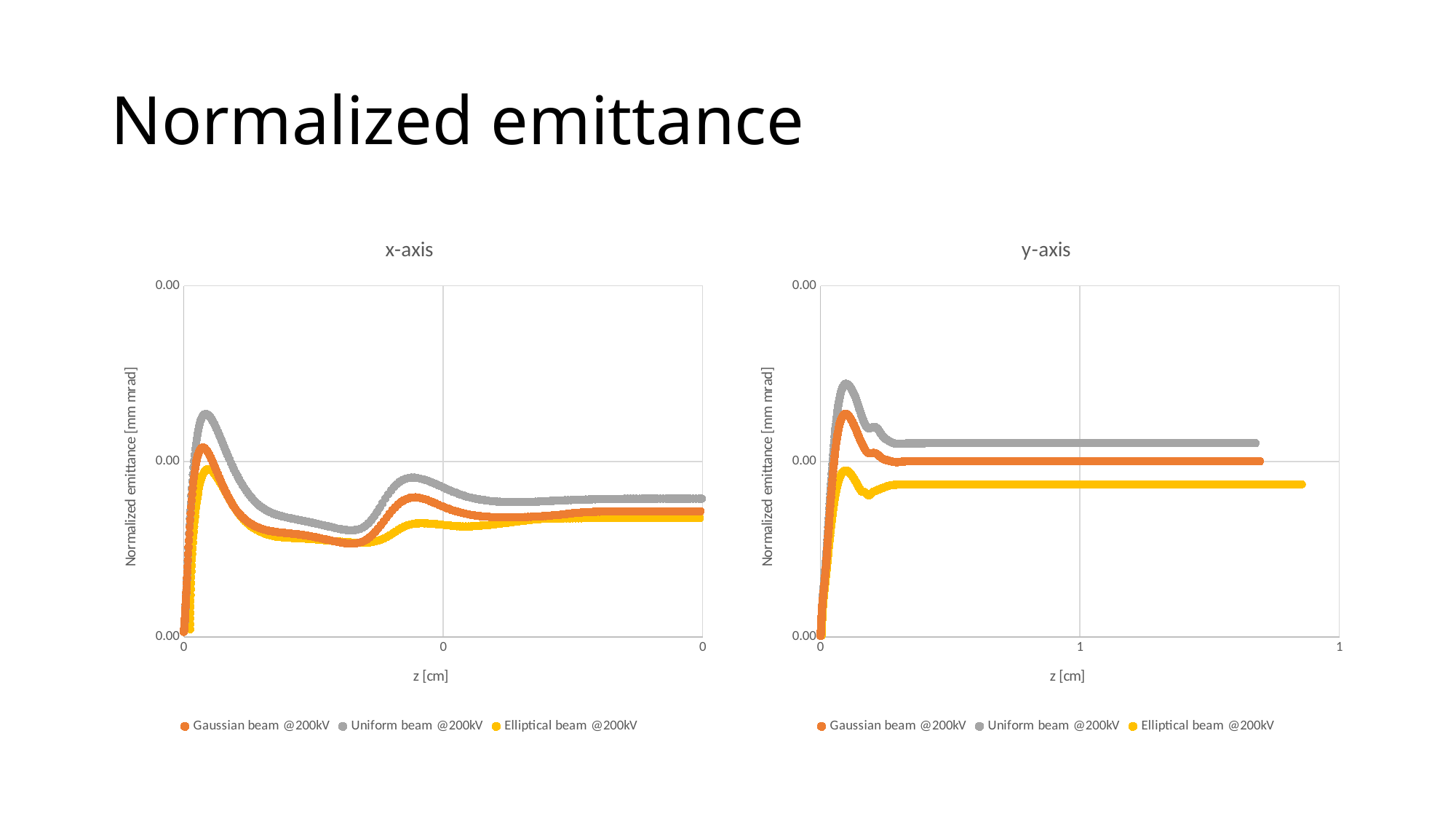
What is the label of the horizontal axis in the y-axis chart? z [cm] In the x-axis chart, which series is higher at the right end of the plot, Uniform beam @200kV or Elliptical beam @200kV? Uniform beam @200kV In the y-axis chart, which series reaches the highest peak? Uniform beam @200kV In the y-axis chart, how many series does the legend list? 3 In the y-axis chart, which series has the lowest peak, Uniform beam @200kV or Elliptical beam @200kV? Elliptical beam @200kV How many charts are shown on the slide? 2 What is the label of the vertical axis in the x-axis chart? Normalized emittance [mm mrad] In the x-axis chart, which series reaches the highest peak? Uniform beam @200kV In the y-axis chart, which series has the lowest values at the right end of the plot? Elliptical beam @200kV What kind of chart is the x-axis chart? Scatter chart In the x-axis chart, how many series does the legend list? 3 In the y-axis chart, which series is higher at the right end of the plot, Gaussian beam @200kV or Uniform beam @200kV? Uniform beam @200kV